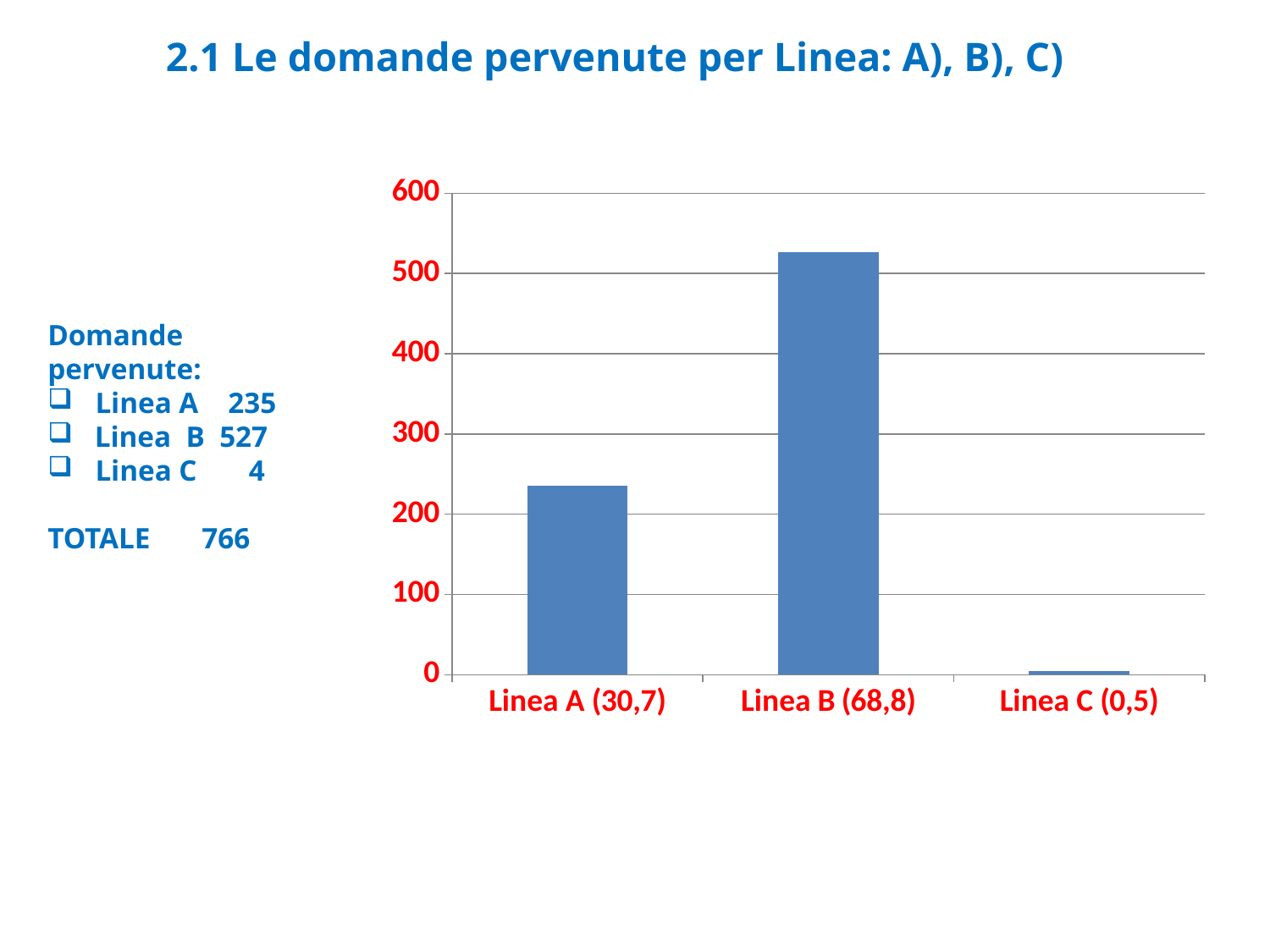
How many categories (bars) does the chart show? 3 Which category has the highest bar in the chart? Linea B (68,8) What kind of chart is shown on the slide? bar chart What is the highest value shown on the vertical axis of the chart? 600 Is the value for Linea B greater or less than 500? greater Which is larger, the value for Linea A or the value for Linea B? Linea B According to the slide, how many domande pervenute are there for Linea A? 235 Is the value for Linea A greater or less than 200? greater Which category has the lowest bar in the chart? Linea C (0,5) Is the value for Linea C greater or less than 100? less According to the slide, how many domande pervenute are there for Linea B? 527 What is the difference between the domande pervenute for Linea B and Linea A, as given on the slide? 292